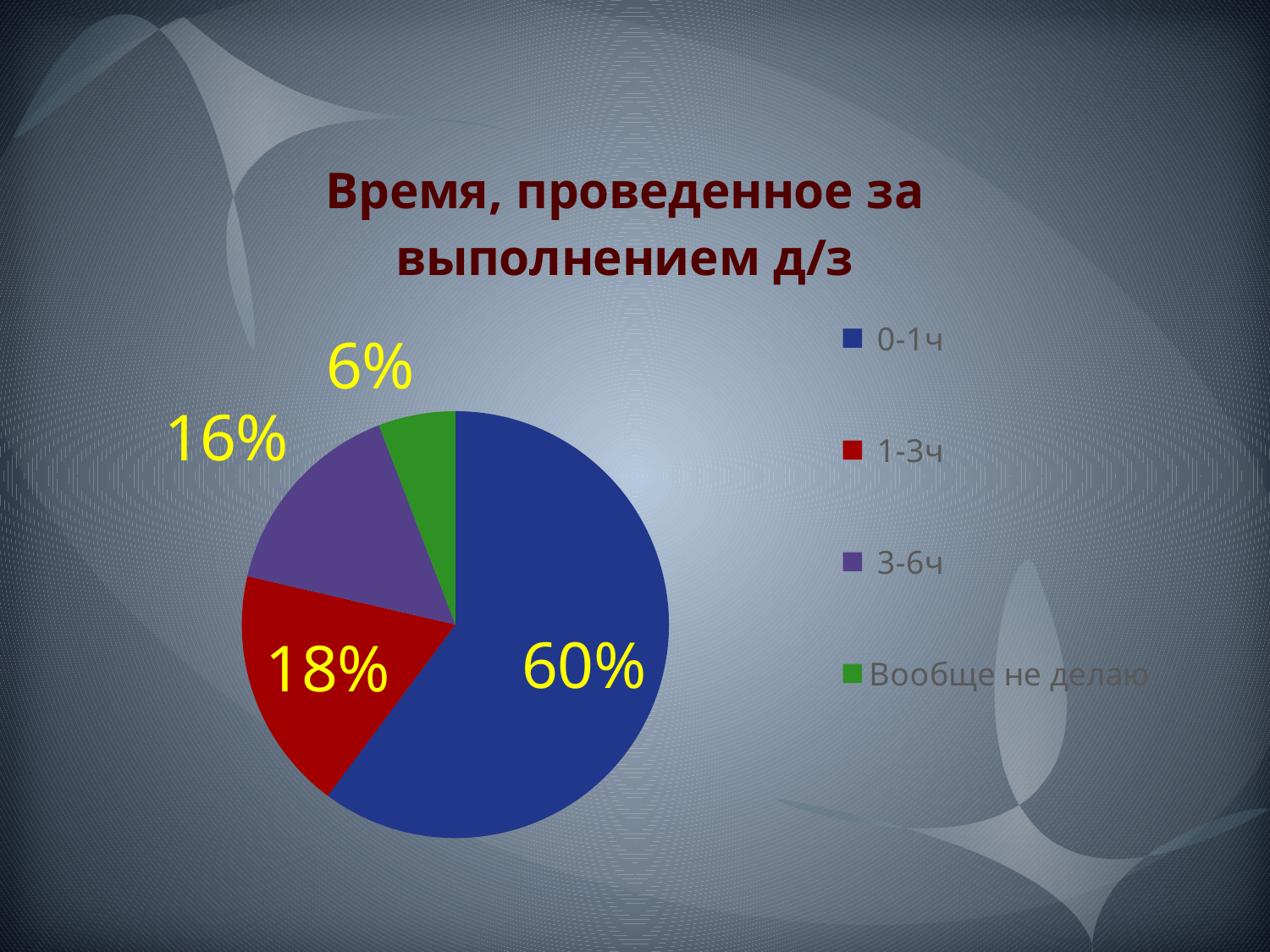
What share of the pie does the "1-3ч" slice represent? 18% What share of the pie does the "3-6ч" slice represent? 16% Which is larger, the "1-3ч" slice or the "3-6ч" slice? 1-3ч What kind of chart is shown on the slide? pie chart What is the title of the chart? Время, проведенное за выполнением д/з What share of the pie does the "0-1ч" slice represent? 60% What colour is the "3-6ч" slice in the pie chart? purple What is the difference between the "0-1ч" share and the "1-3ч" share? 42% How many categories does the pie chart have? 4 Which category has the largest slice of the pie? 0-1ч Which category has the smallest slice of the pie? Вообще не делаю